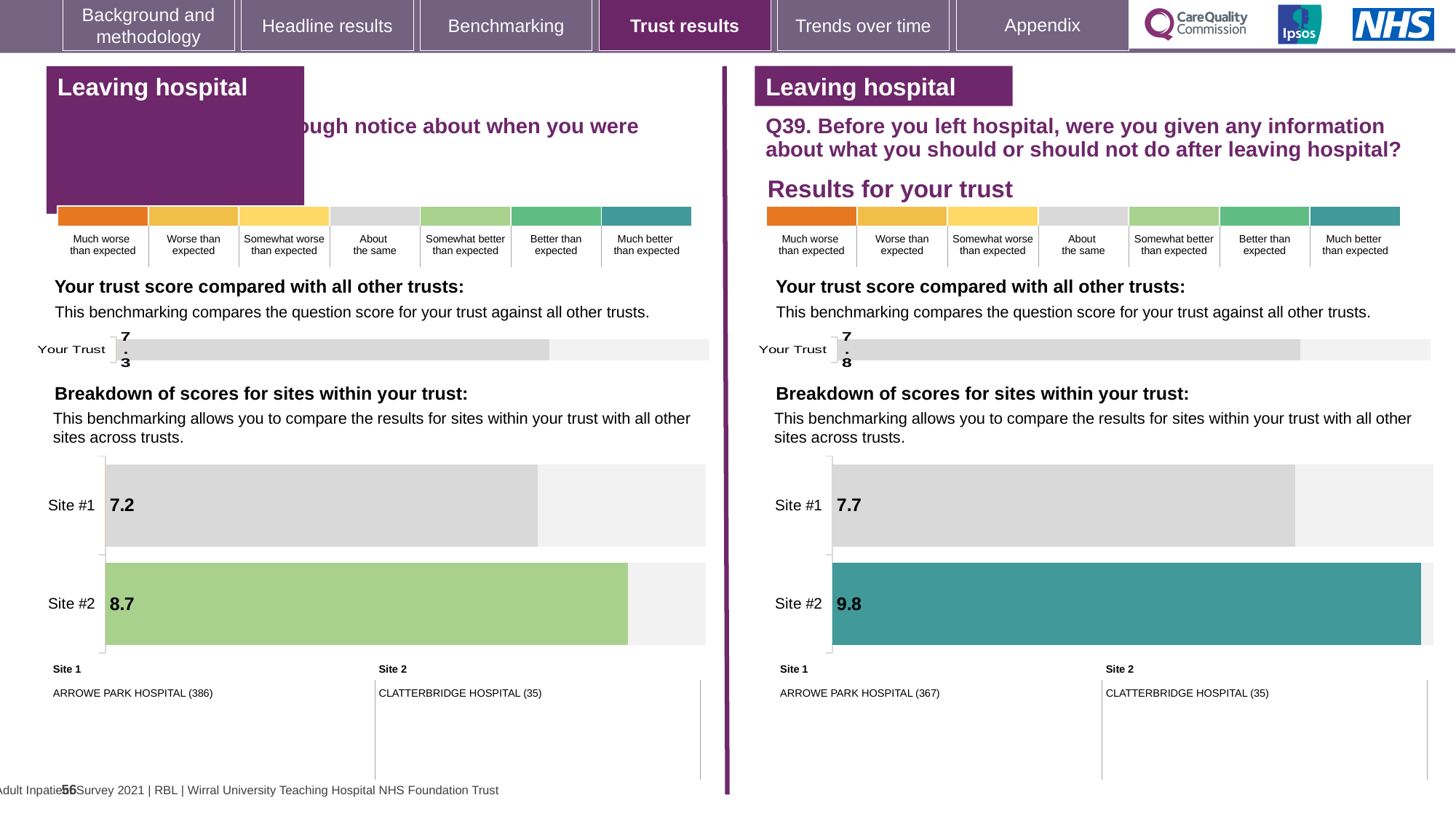
On the right-hand chart (Q39), what is the 'Your Trust' score? 7.8 On the right-hand chart (Q39), what is the score for Site #2? 9.8 On the left-hand site breakdown chart, what is the score for Site #2? 8.7 On the left-hand site breakdown chart, which site has the lower score? Site #1 On the left-hand site breakdown chart, what is the difference between the Site #2 and Site #1 scores? 1.5 On the left-hand chart, what is the 'Your Trust' score? 7.3 What type of chart is used for the breakdown of scores for sites on the right-hand side (Q39)? Bar chart On the left-hand site breakdown chart, what is the score for Site #1? 7.2 On the right-hand chart (Q39), what is the score for Site #1? 7.7 How many sites are shown in the site breakdown chart on the right-hand side (Q39)? 2 On the right-hand chart (Q39), which site has the higher score? Site #2 On the right-hand chart (Q39), what is the difference between the Site #2 and Site #1 scores? 2.1